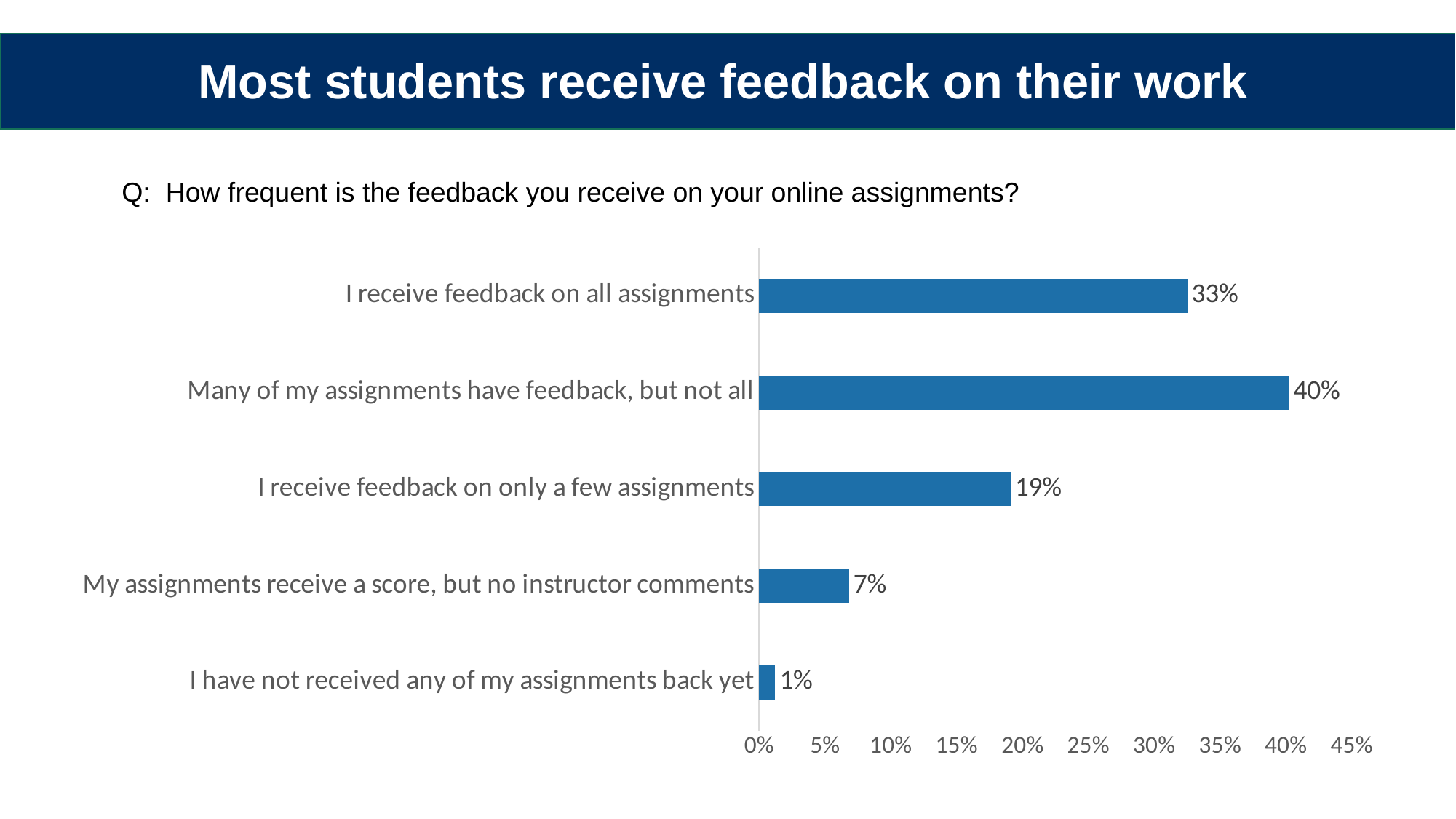
What is the difference between "Many of my assignments have feedback, but not all" and "I receive feedback on all assignments"? 7% What percentage of students say they receive feedback on only a few assignments? 19% Which response has the highest percentage? Many of my assignments have feedback, but not all Which response has the lowest percentage? I have not received any of my assignments back yet Which is larger: "I receive feedback on only a few assignments" or "My assignments receive a score, but no instructor comments"? I receive feedback on only a few assignments Is the value for "I receive feedback on all assignments" greater or less than 30%? greater What is the value for "My assignments receive a score, but no instructor comments"? 7% What percentage of students say they receive feedback on all assignments? 33% What is the value for "Many of my assignments have feedback, but not all"? 40% How many response categories are shown in the chart? 5 What kind of chart is shown on the slide? bar chart What is the title of the slide? Most students receive feedback on their work